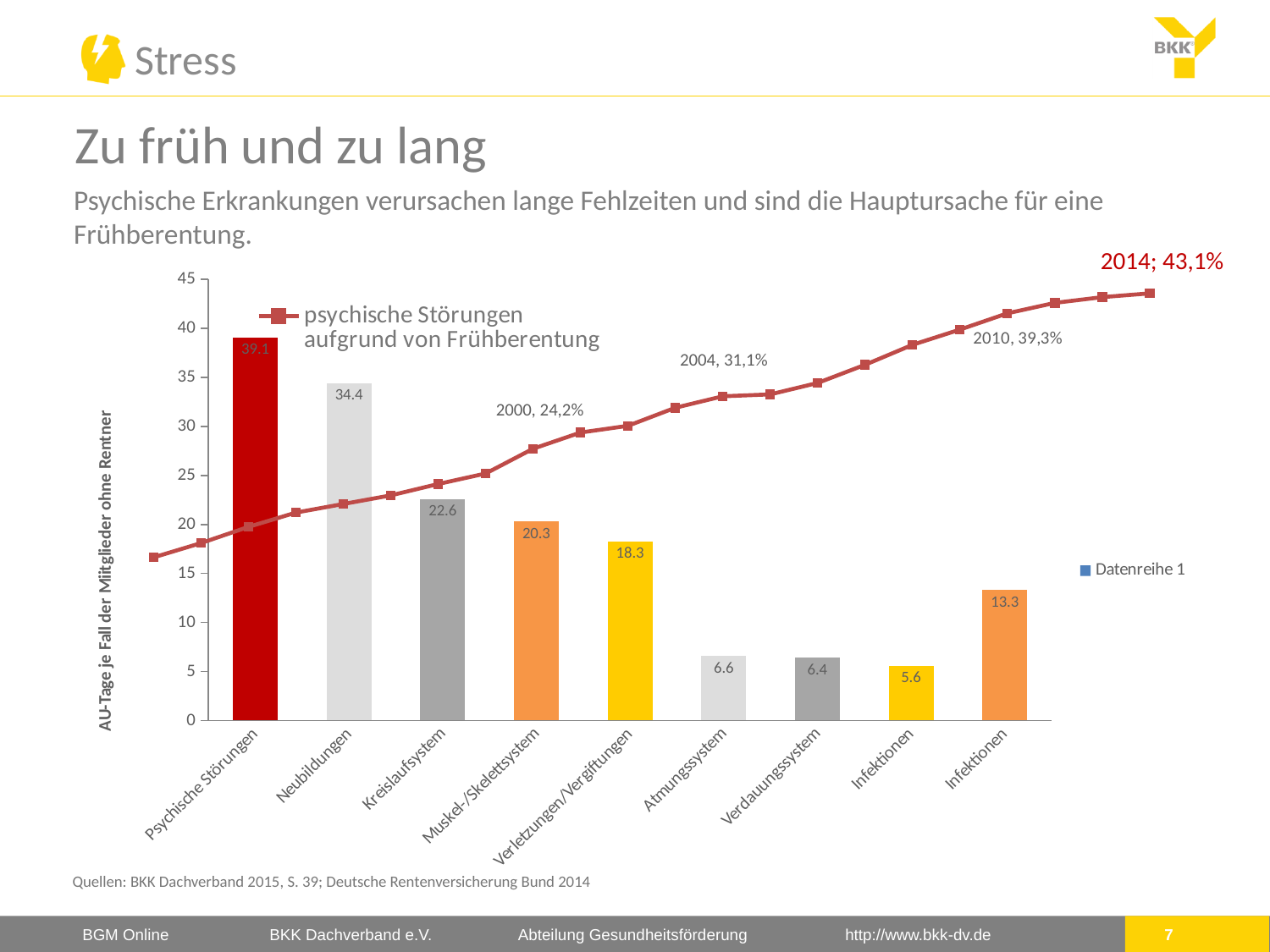
What is the value for Psychische Störungen in the bar chart? 39.1 Does the line 'psychische Störungen aufgrund von Frühberentung' rise or fall from left to right? rise What value does the line show for 2000? 24,2% What is the title of the vertical axis? AU-Tage je Fall der Mitglieder ohne Rentner Which category has the highest bar? Psychische Störungen What is the value for Neubildungen? 34.4 What is the value for Kreislaufsystem? 22.6 Which is larger, the value for Muskel-/Skelettsystem or for Verletzungen/Vergiftungen? Muskel-/Skelettsystem How many bars are plotted in the chart? 9 Is the value for Atmungssystem greater or less than 10? less What is the difference between the values for Psychische Störungen and Neubildungen? 4.7 What value does the line 'psychische Störungen aufgrund von Frühberentung' show for 2014? 43,1%